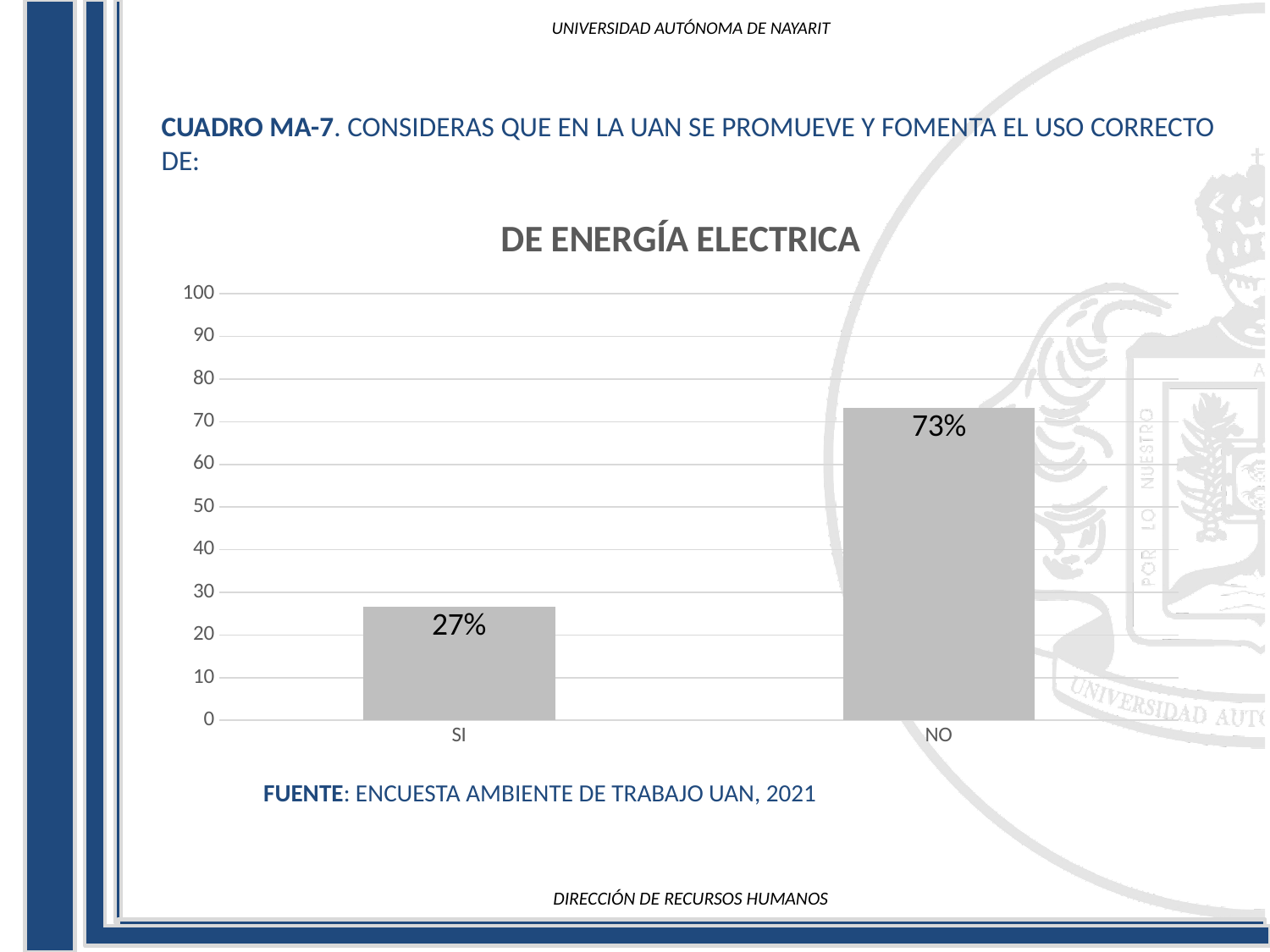
What kind of chart is shown on the slide? bar chart What is the difference between the values for NO and SI? 46% What is the highest value shown on the y axis? 100 Which is larger, the value for SI or the value for NO? NO Is the value for SI greater or less than 30? less Which category has the highest value? NO What is the value for SI? 27% Which category has the lowest value? SI What is the title of the chart? DE ENERGÍA ELECTRICA Is the value for NO greater or less than 50? greater What is the value for NO? 73% How many categories are shown on the x axis? 2